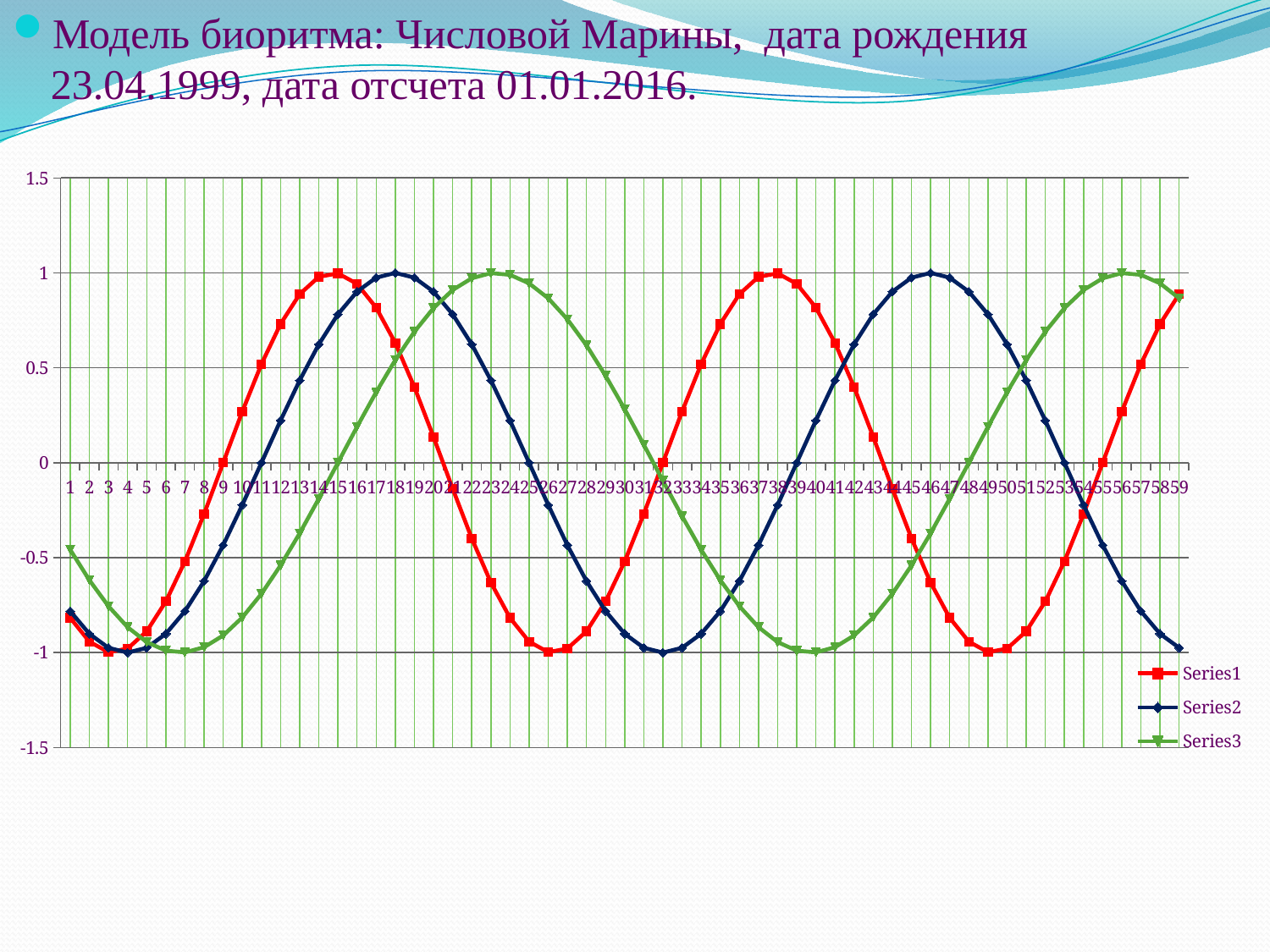
What kind of chart is shown on the slide? line chart Is the value of Series1 at x = 4 greater or less than -0.5? less At x = 40, which series has the lowest value? Series3 At x = 10, which is larger: the value of Series1 or the value of Series3? Series1 At x = 18, which series has the highest value? Series2 Is the value of Series2 at x = 18 greater or less than 0.5? greater How many series does the legend list? 3 Is the value of Series2 at x = 32 greater or less than -0.5? less Does Series1 rise or fall between x = 4 and x = 14? rise How many points are plotted along the x axis for each series? 59